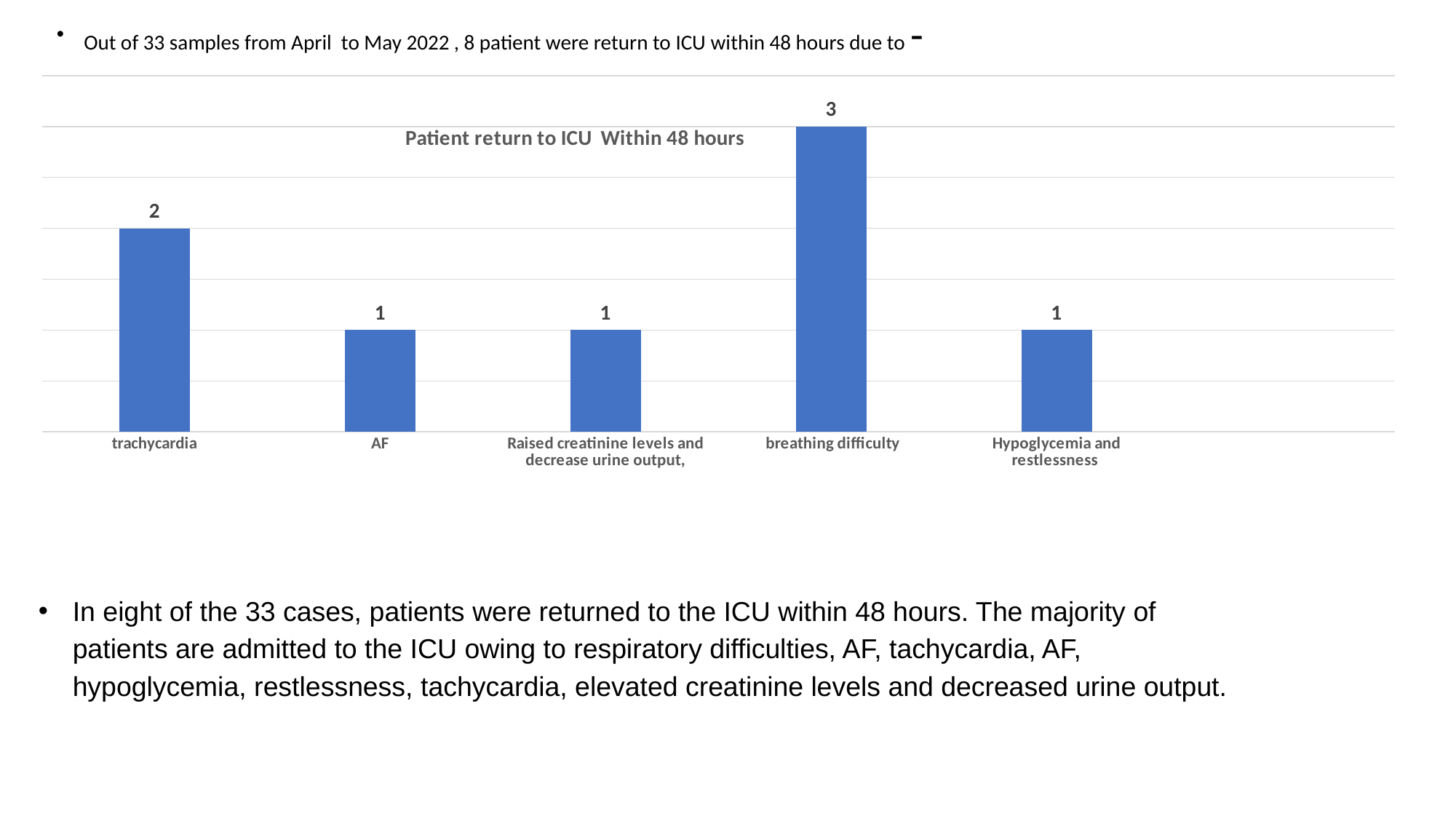
How many categories are shown in the chart? 5 Which category has the highest value? breathing difficulty What kind of chart is shown on the slide? bar chart What is the value for breathing difficulty? 3 What colour are the bars in the chart? blue What is the title of the chart? Patient return to ICU Within 48 hours What is the value for Hypoglycemia and restlessness? 1 What is the difference between the values for breathing difficulty and trachycardia? 1 What is the total of all the values shown in the chart? 8 What is the value for trachycardia? 2 What is the value for AF? 1 Which is larger, the value for trachycardia or the value for AF? trachycardia